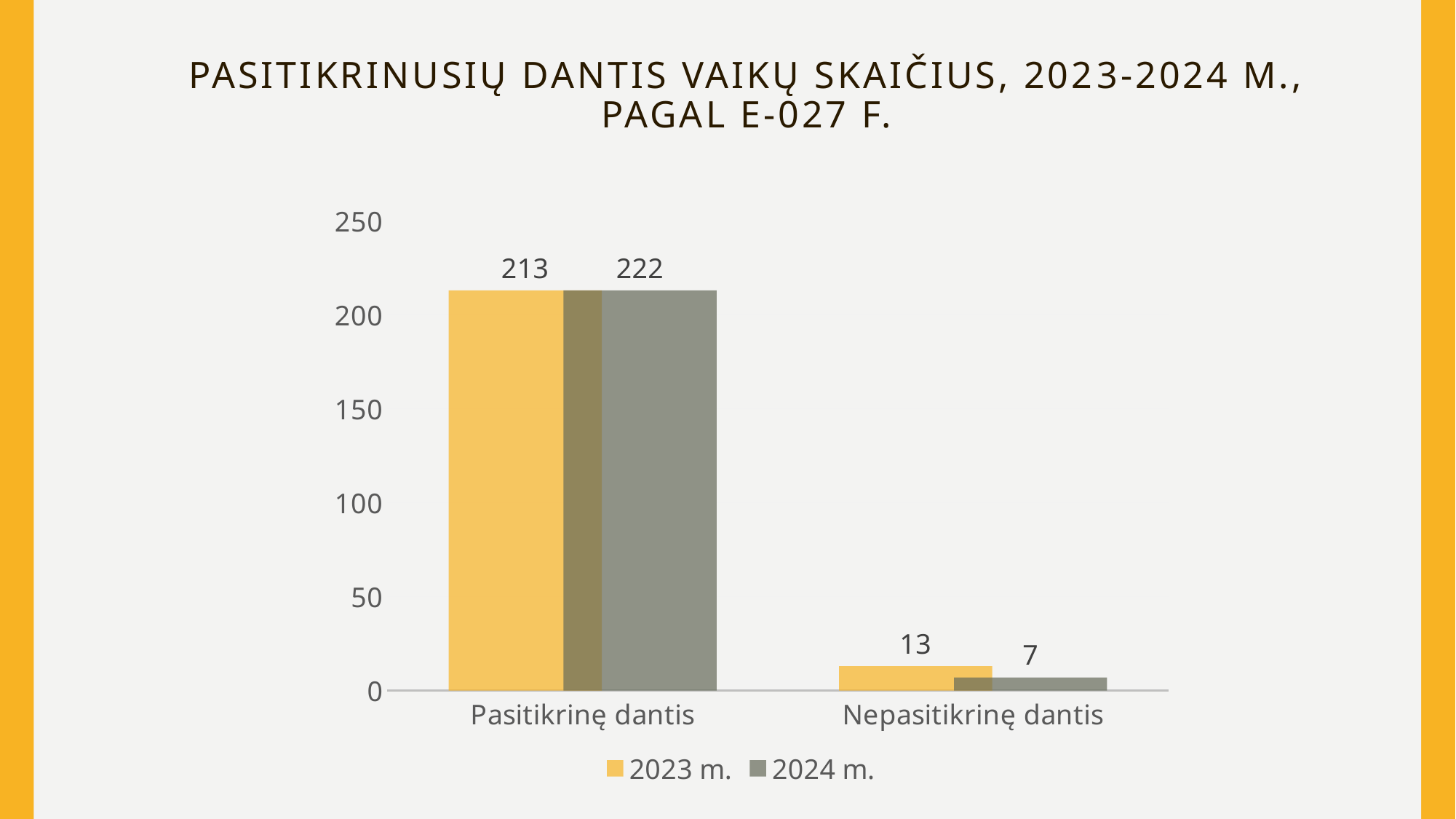
What is the difference between the 2024 m. and 2023 m. values for "Pasitikrinę dantis"? 9 What is the value for "Pasitikrinę dantis" in the 2024 m. series? 222 What is the difference between the 2023 m. and 2024 m. values for "Nepasitikrinę dantis"? 6 What is the value for "Nepasitikrinę dantis" in the 2024 m. series? 7 What is the value for "Nepasitikrinę dantis" in the 2023 m. series? 13 Which is larger for "Nepasitikrinę dantis": the 2023 m. value or the 2024 m. value? 2023 m. What is the value for "Pasitikrinę dantis" in the 2023 m. series? 213 Which category has the lowest value in the 2023 m. series? Nepasitikrinę dantis How many series does the legend list? 2 Which category has the highest value in the 2024 m. series? Pasitikrinę dantis What kind of chart is shown on the slide? Bar chart How many categories are shown on the x axis? 2